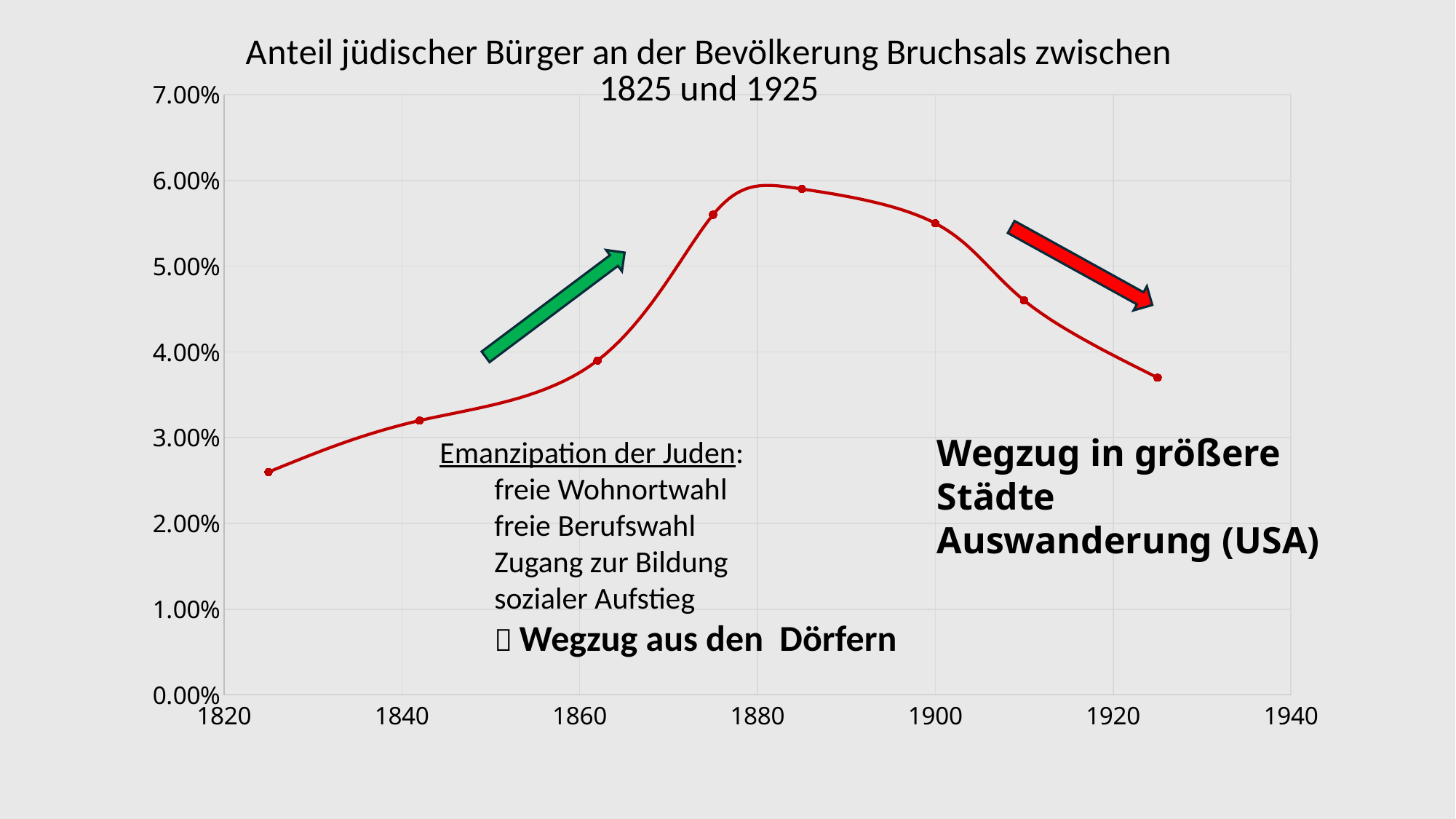
Is the value for 1925 greater or less than the value for 1825? greater What is the title of the chart? Anteil jüdischer Bürger an der Bevölkerung Bruchsals zwischen 1825 und 1925 Is the value for 1900 greater or less than 5.00%? greater How many data points are plotted on the line? 8 Is the value for 1825 greater or less than 3.00%? less Does the share rise or fall between 1825 and 1880? rise Does the share rise or fall between 1900 and 1925? fall Is the value for 1910 greater or less than 4.00%? greater What kind of chart is shown on the slide? line chart Which year has the lowest share of Jewish citizens on the chart? 1825